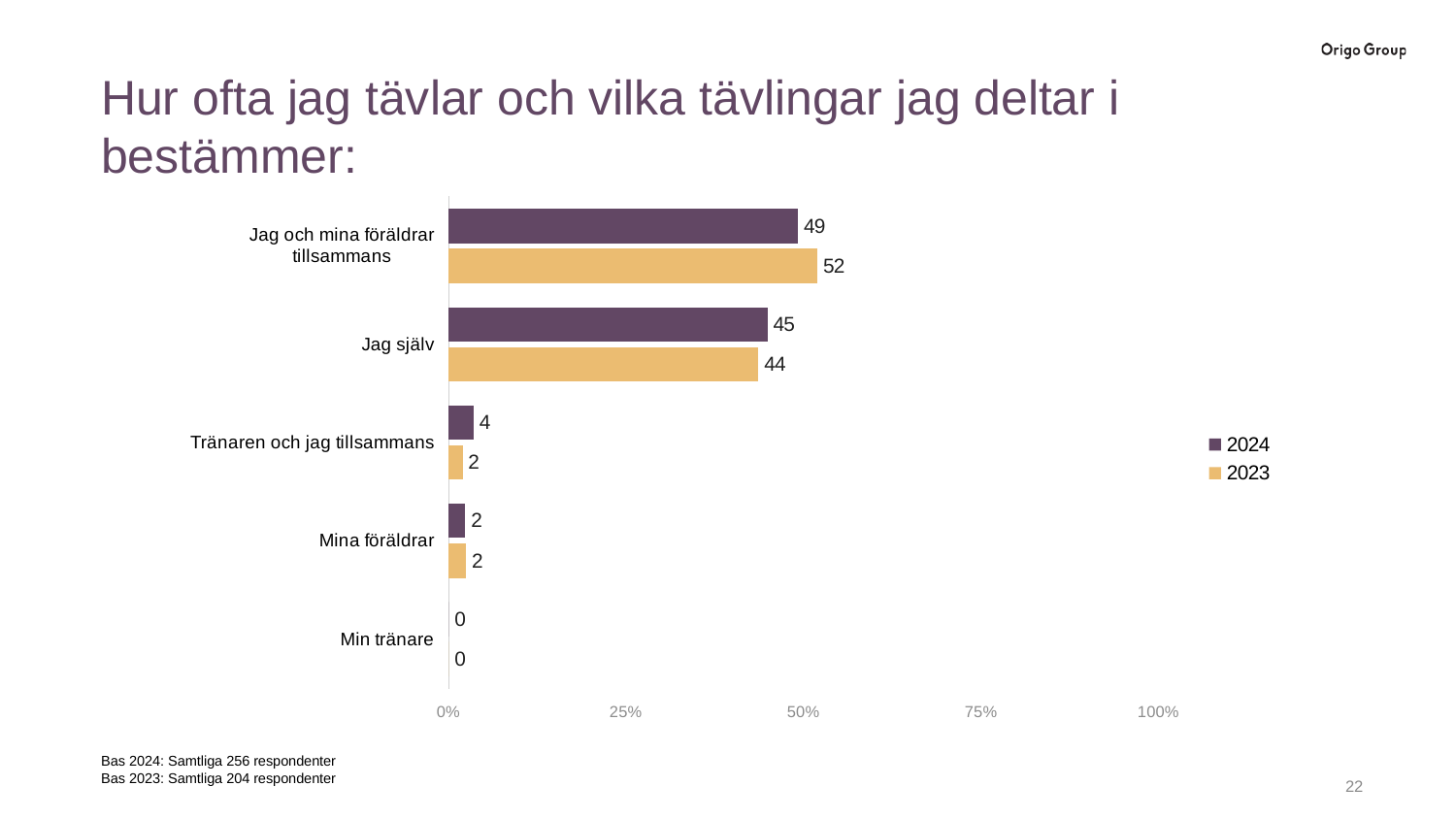
What is the 2023 value for "Jag själv"? 44 Which series is shown in purple according to the legend? 2024 How many series does the legend list? 2 For "Jag själv", which year has the larger value, 2024 or 2023? 2024 Which category has the lowest 2024 value? Min tränare What is the 2024 value for "Jag och mina föräldrar tillsammans"? 49 Is the 2023 value for "Jag och mina föräldrar tillsammans" greater or less than 50%? greater How many categories are shown on the chart? 5 What kind of chart is shown on the slide? Bar chart What is the difference between the 2023 and 2024 values for "Jag och mina föräldrar tillsammans"? 3 Which category has the highest 2023 value? Jag och mina föräldrar tillsammans What is the 2024 value for "Tränaren och jag tillsammans"? 4